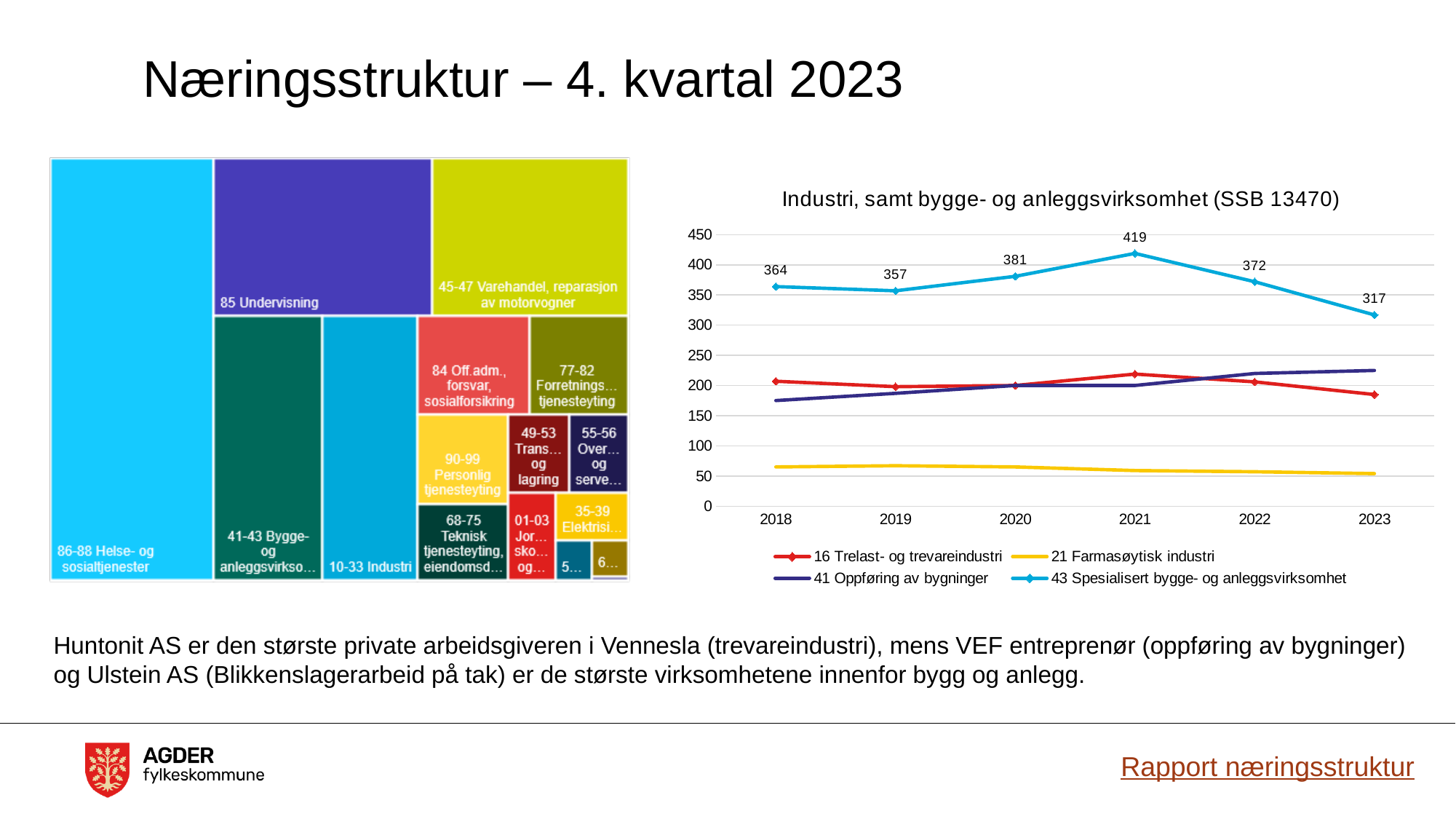
In the line chart 'Industri, samt bygge- og anleggsvirksomhet (SSB 13470)', what is the value for 43 Spesialisert bygge- og anleggsvirksomhet in 2021? 419 In the line chart 'Industri, samt bygge- og anleggsvirksomhet (SSB 13470)', what is the value for 43 Spesialisert bygge- og anleggsvirksomhet in 2023? 317 In the line chart on the right, is the value for 41 Oppføring av bygninger in 2023 greater or less than 200? greater In the line chart on the right, is the value for 21 Farmasøytisk industri in 2018 greater or less than 100? less How many series does the legend of the line chart on the right list? 4 In the line chart on the right, is the value for 43 Spesialisert bygge- og anleggsvirksomhet larger in 2020 or in 2022? 2020 In the line chart on the right, in which year does 43 Spesialisert bygge- og anleggsvirksomhet reach its highest value? 2021 In the line chart on the right, does the value for 43 Spesialisert bygge- og anleggsvirksomhet rise or fall from 2021 to 2023? fall In the line chart on the right, what is the difference between the 2021 and 2023 values for 43 Spesialisert bygge- og anleggsvirksomhet? 102 How many years are shown on the x axis of the line chart on the right? 6 What kind of chart is the chart on the right of the slide? line chart In the line chart on the right, in which year does 43 Spesialisert bygge- og anleggsvirksomhet have its lowest value? 2023